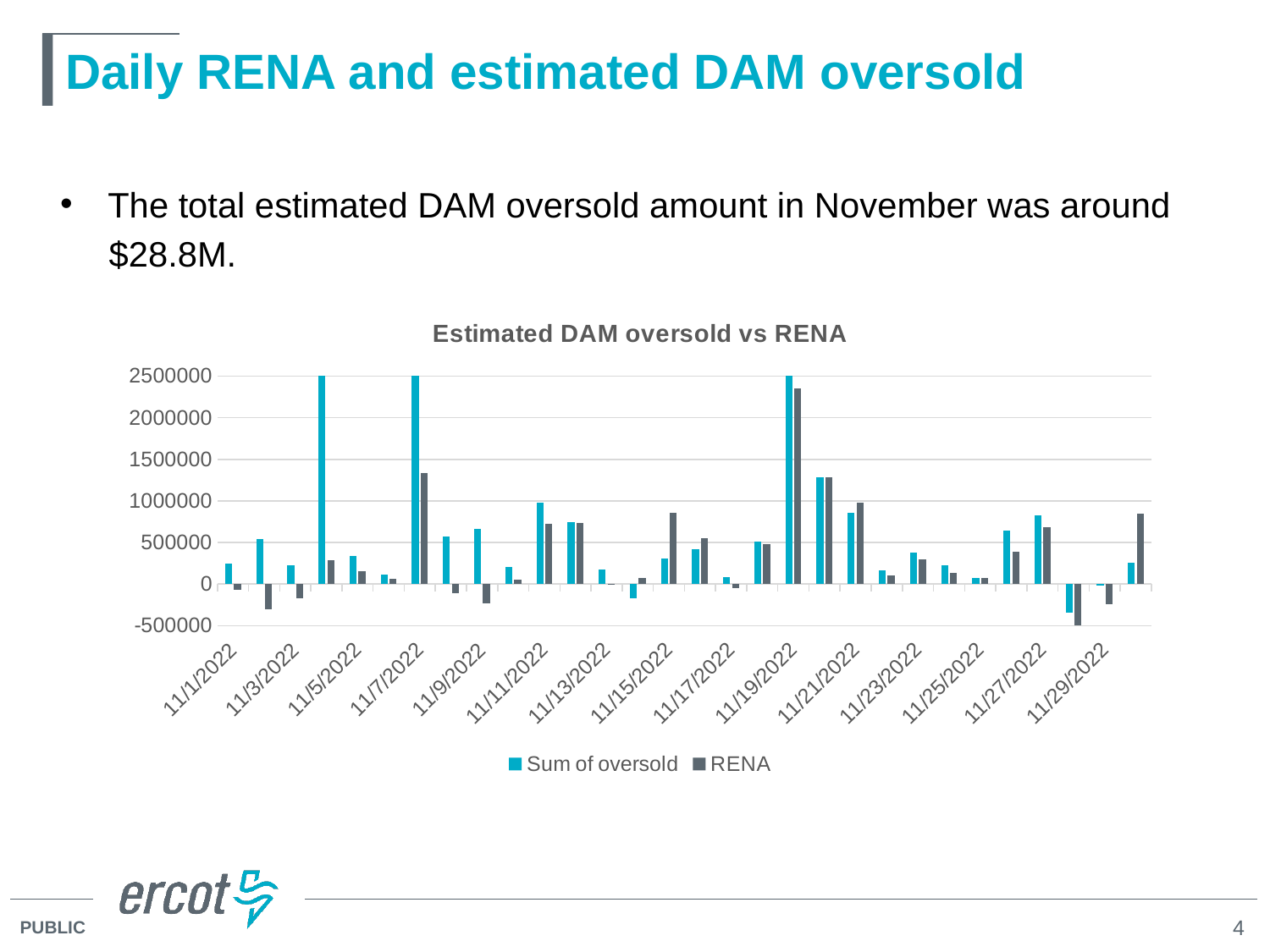
On 11/7/2022, which series has the larger value, Sum of oversold or RENA? Sum of oversold Is the RENA value for 11/19/2022 greater or less than 2000000? greater What are the two series named in the legend? Sum of oversold and RENA On 11/15/2022, which series has the larger value, Sum of oversold or RENA? RENA What is the title of the chart? Estimated DAM oversold vs RENA Is the Sum of oversold value for 11/7/2022 greater or less than 2000000? greater What kind of chart is shown on the slide? Bar chart How many date labels are shown on the x axis? 15 Which labeled date has the highest RENA value? 11/19/2022 Is the RENA value for 11/7/2022 greater or less than 1000000? greater How many series does the legend list? 2